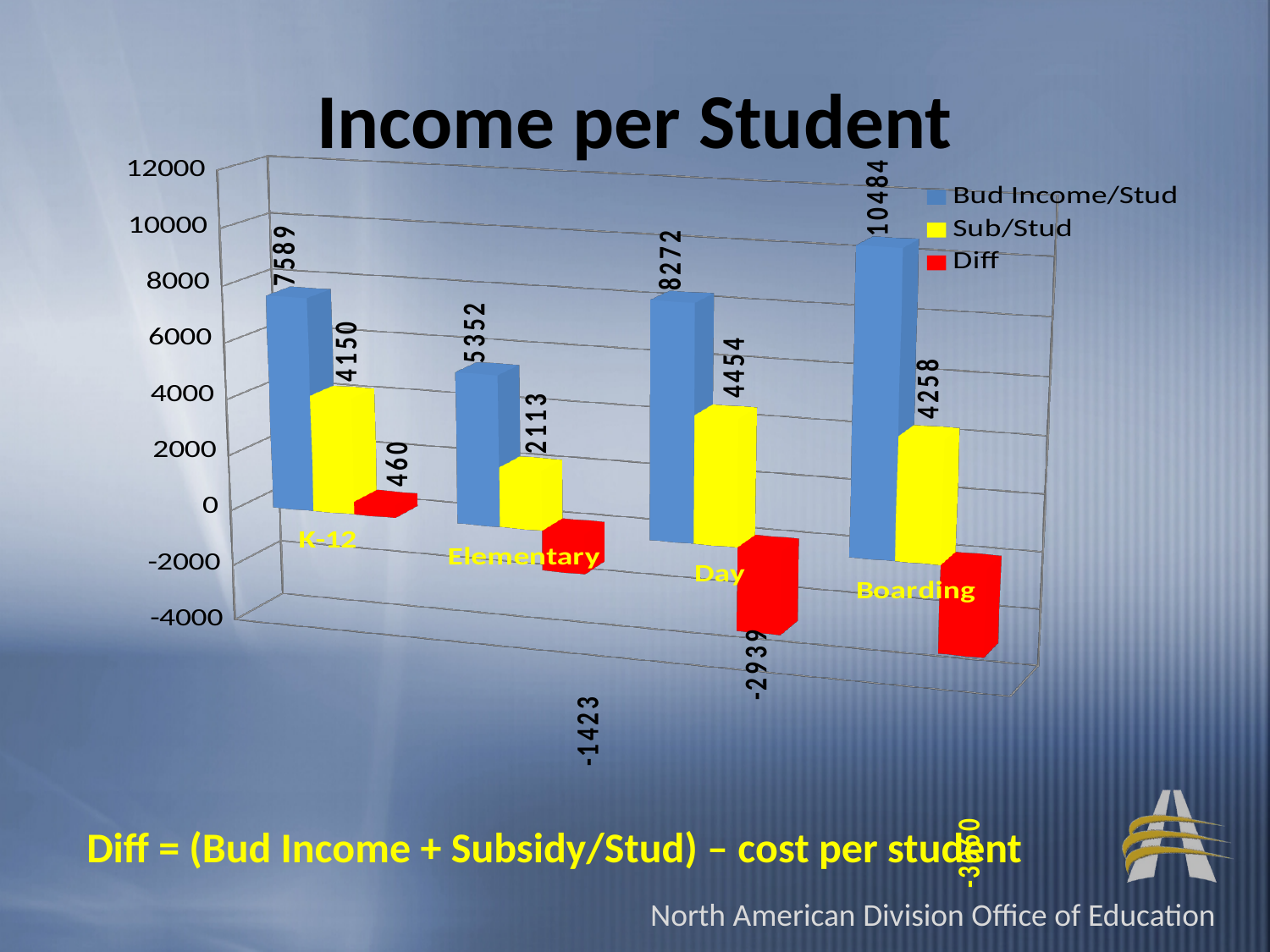
What is the difference between the Bud Income/Stud values for Boarding and K-12? 2895 What is the Sub/Stud value for Day? 4454 Which category has the highest Bud Income/Stud value? Boarding Which category has the highest Sub/Stud value? Day What is the Diff value for Elementary? -1423 What is the Bud Income/Stud value for Boarding? 10484 What is the Diff value for Day? -2939 Which is larger, the Sub/Stud value for K-12 or for Boarding? Boarding What kind of chart is shown on the slide? Bar chart Which category has the lowest Bud Income/Stud value? Elementary How many categories are shown on the x axis? 4 How many series does the legend list? 3